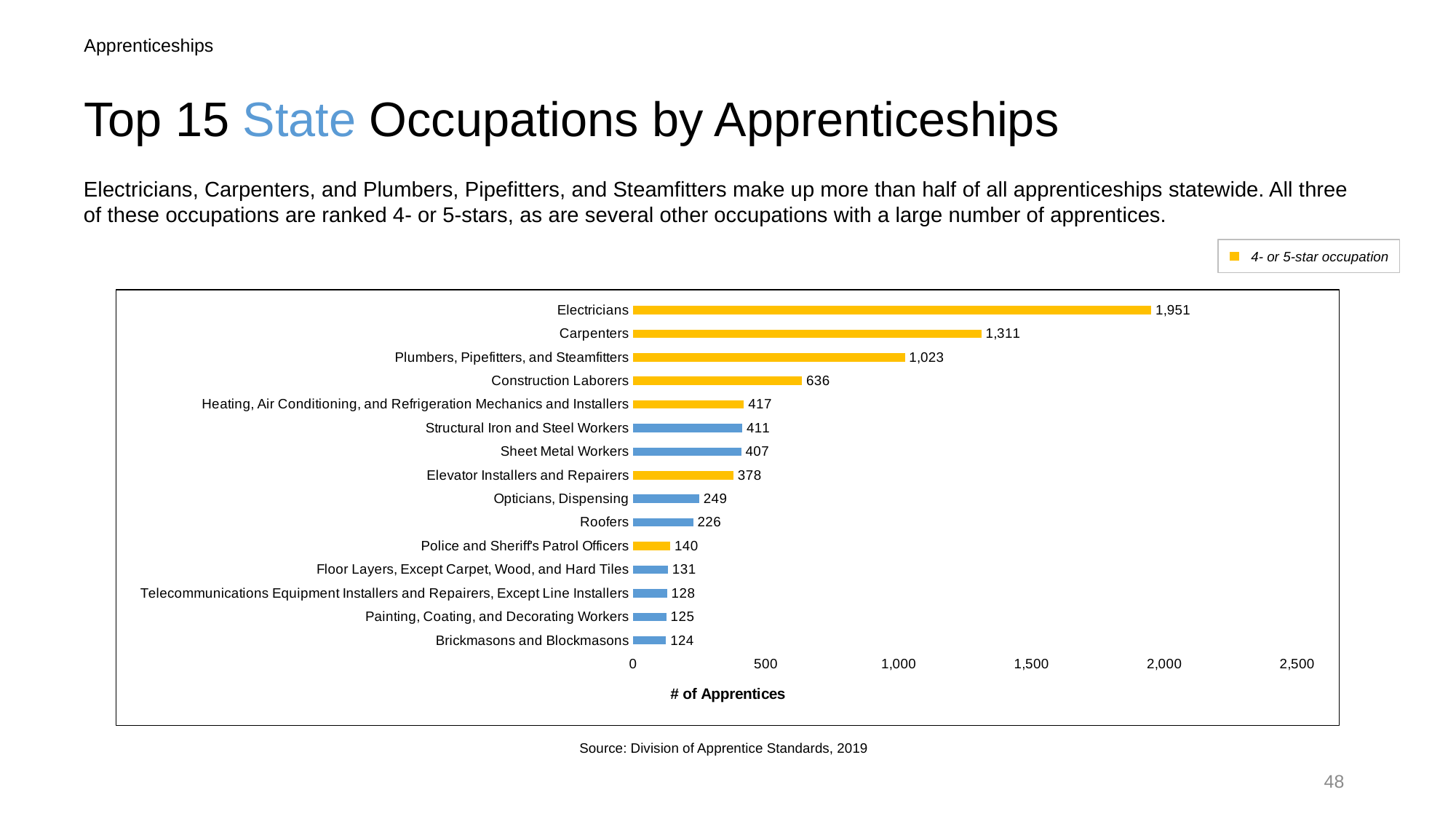
What type of chart is shown on the slide? Bar chart How many occupations are shown in the chart? 15 What is the difference in apprentices between Electricians and Carpenters? 640 How many apprentices are there for Electricians? 1,951 What is the number of apprentices for Sheet Metal Workers? 407 Which occupation has the highest number of apprentices? Electricians What is the label of the horizontal axis of the chart? # of Apprentices Which occupation has the lowest number of apprentices? Brickmasons and Blockmasons How many apprentices are shown for Roofers? 226 Which has more apprentices, Opticians, Dispensing or Roofers? Opticians, Dispensing Is the value for Plumbers, Pipefitters, and Steamfitters greater or less than 1,000? greater What is the difference in apprentices between Construction Laborers and Elevator Installers and Repairers? 258